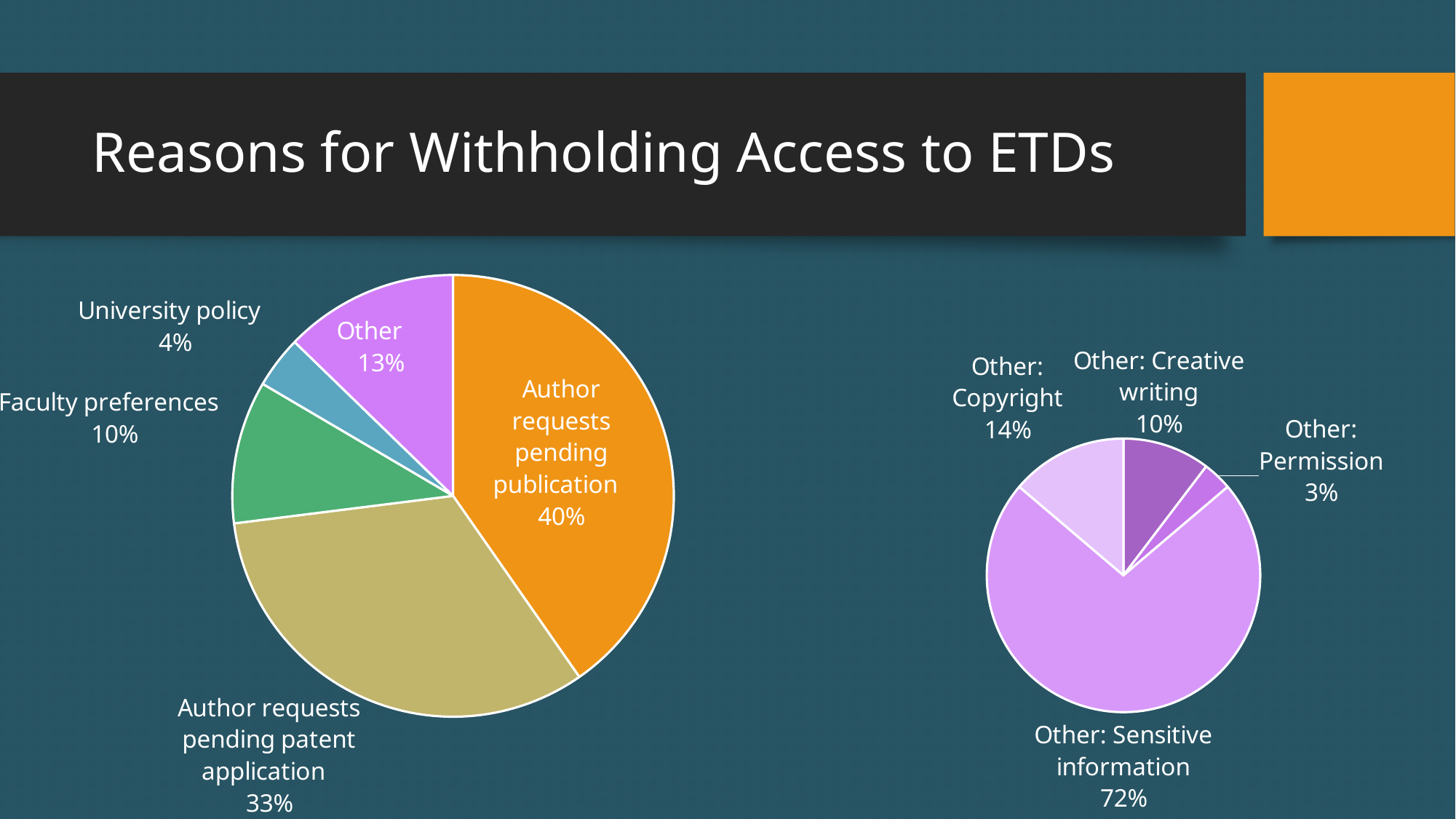
On the left pie chart, what percentage is shown for University policy? 4% What type of chart is shown on the right side of the slide? Pie chart On the right pie chart, what is the difference in percentage points between Other: Copyright and Other: Creative writing? 4 What is the title of the slide containing the two pie charts? Reasons for Withholding Access to ETDs On the left pie chart, what share is labelled for Author requests pending publication? 40% How many slices does the left pie chart have? 5 On the right pie chart, which category has the smallest slice? Other: Permission On the left pie chart, which category has the smallest slice? University policy On the right pie chart, what percentage is shown for Other: Sensitive information? 72% On the left pie chart, which is larger: Faculty preferences or Other? Other On the left pie chart, which category has the largest slice? Author requests pending publication On the left pie chart, what is the difference in percentage points between Author requests pending publication and Author requests pending patent application? 7